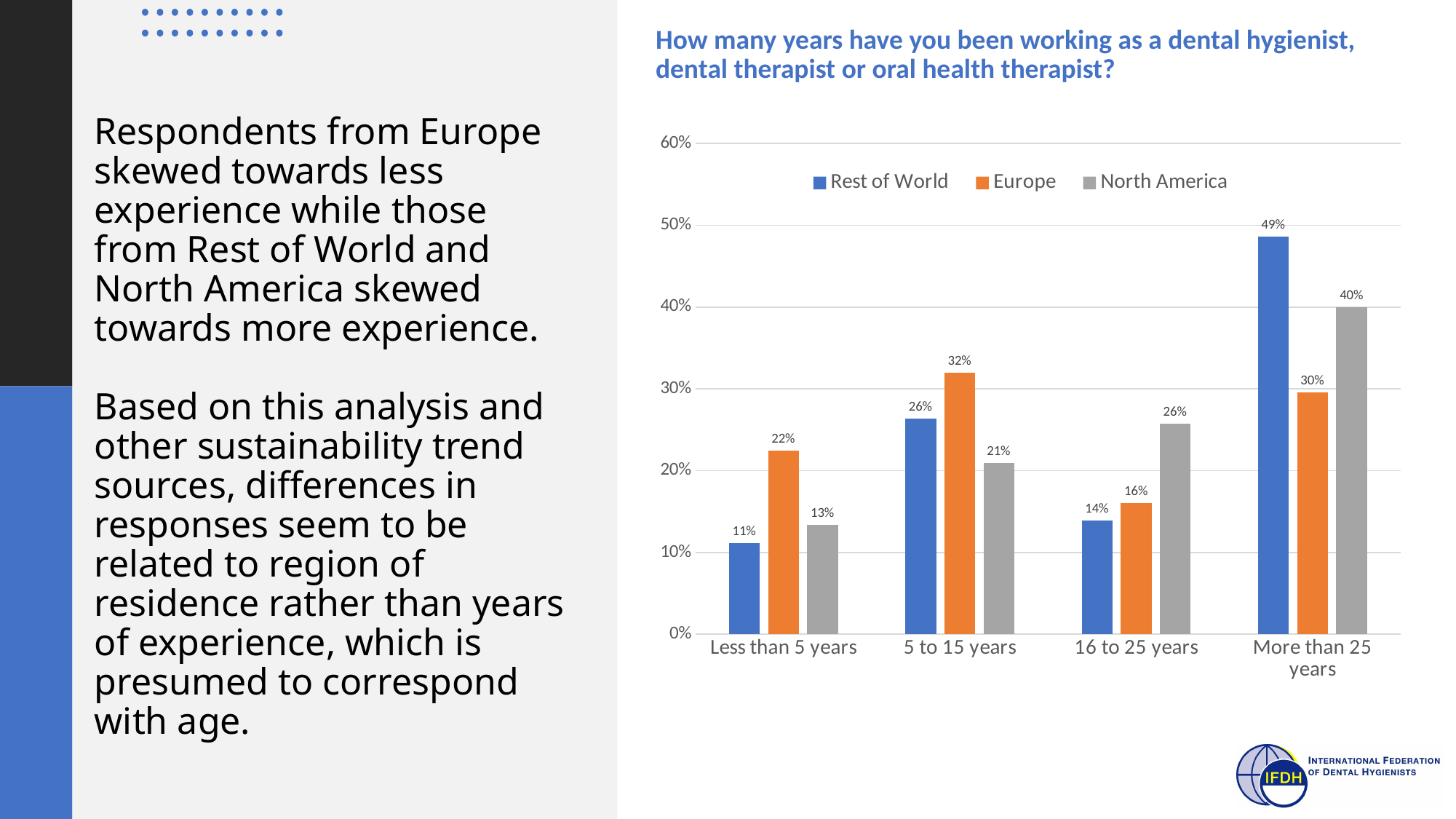
Which colour represents the Europe series in the chart? Orange In the 16 to 25 years category, which series has the larger value, Rest of World or North America? North America Which category has the lowest value for the Rest of World series? Less than 5 years What is the value for Europe in the 5 to 15 years category? 32% What is the difference between the North America and Europe values in the More than 25 years category? 10% What percentage of Rest of World respondents have been working for more than 25 years? 49% How many year-range categories are shown on the x axis? 4 What kind of chart is shown on the slide? Bar chart How many series does the legend list? 3 What is the value for North America in the Less than 5 years category? 13% Do the values for the Rest of World series rise or fall from the 16 to 25 years category to the More than 25 years category? Rise Which category has the highest value for the Europe series? 5 to 15 years